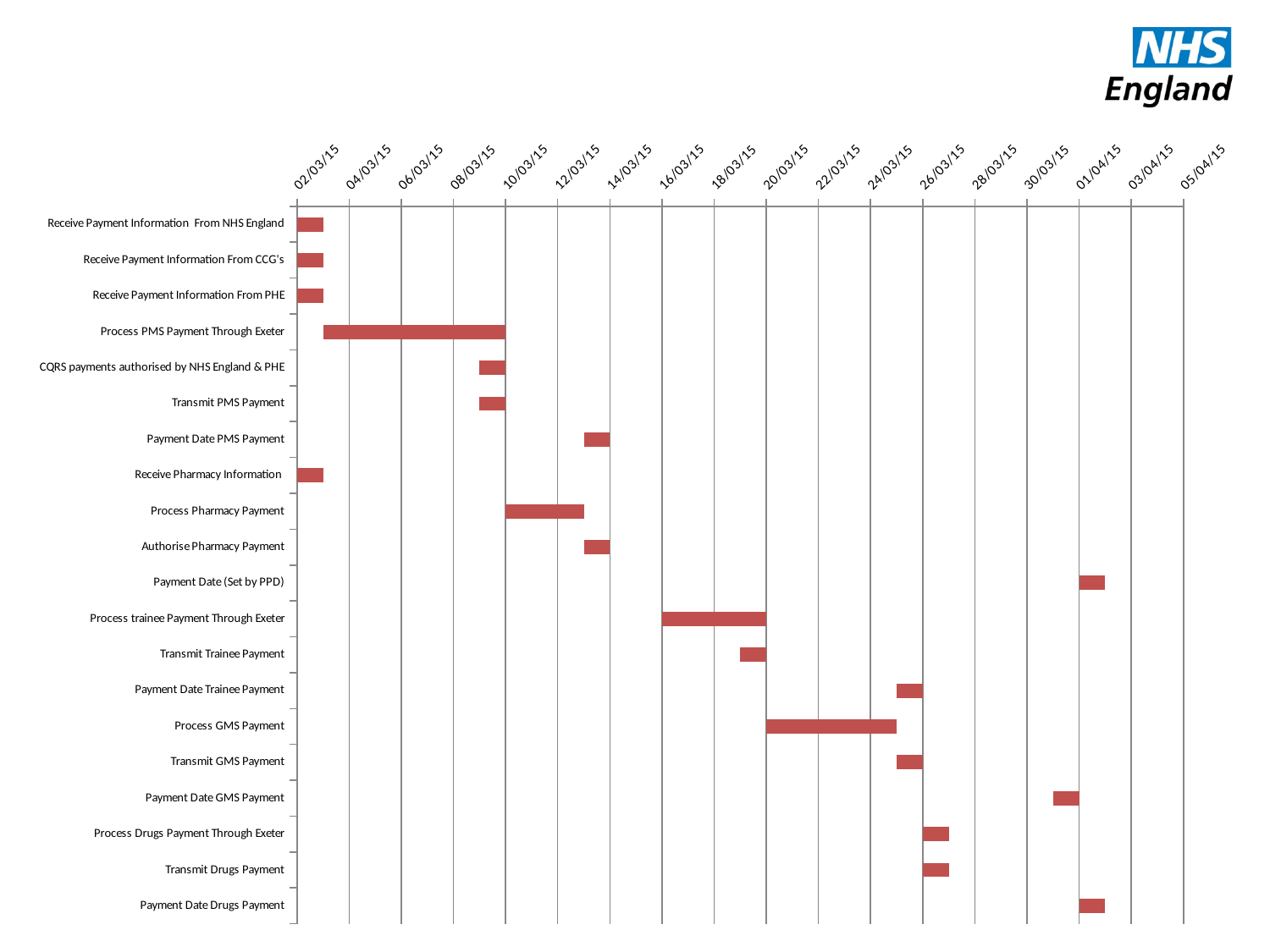
On what date does the bar for Process trainee Payment Through Exeter start? 16/03/15 Which task has the longest bar in the chart? Process PMS Payment Through Exeter Which task occurs later, Payment Date GMS Payment or Payment Date Trainee Payment? Payment Date GMS Payment On what date does the bar for Process Pharmacy Payment start? 10/03/15 What is the first date shown on the horizontal axis of the chart? 02/03/15 Does the bar for Transmit PMS Payment fall before or after 12/03/15? before On what date does the bar for Process GMS Payment start? 20/03/15 Does the bar for Payment Date Drugs Payment fall before or after 30/03/15? after On what date does the bar for Process PMS Payment Through Exeter end? 10/03/15 How many tasks are listed on the vertical axis of the chart? 20 What kind of chart is shown on the slide? bar chart Which bar is longer, Process GMS Payment or Process Pharmacy Payment? Process GMS Payment